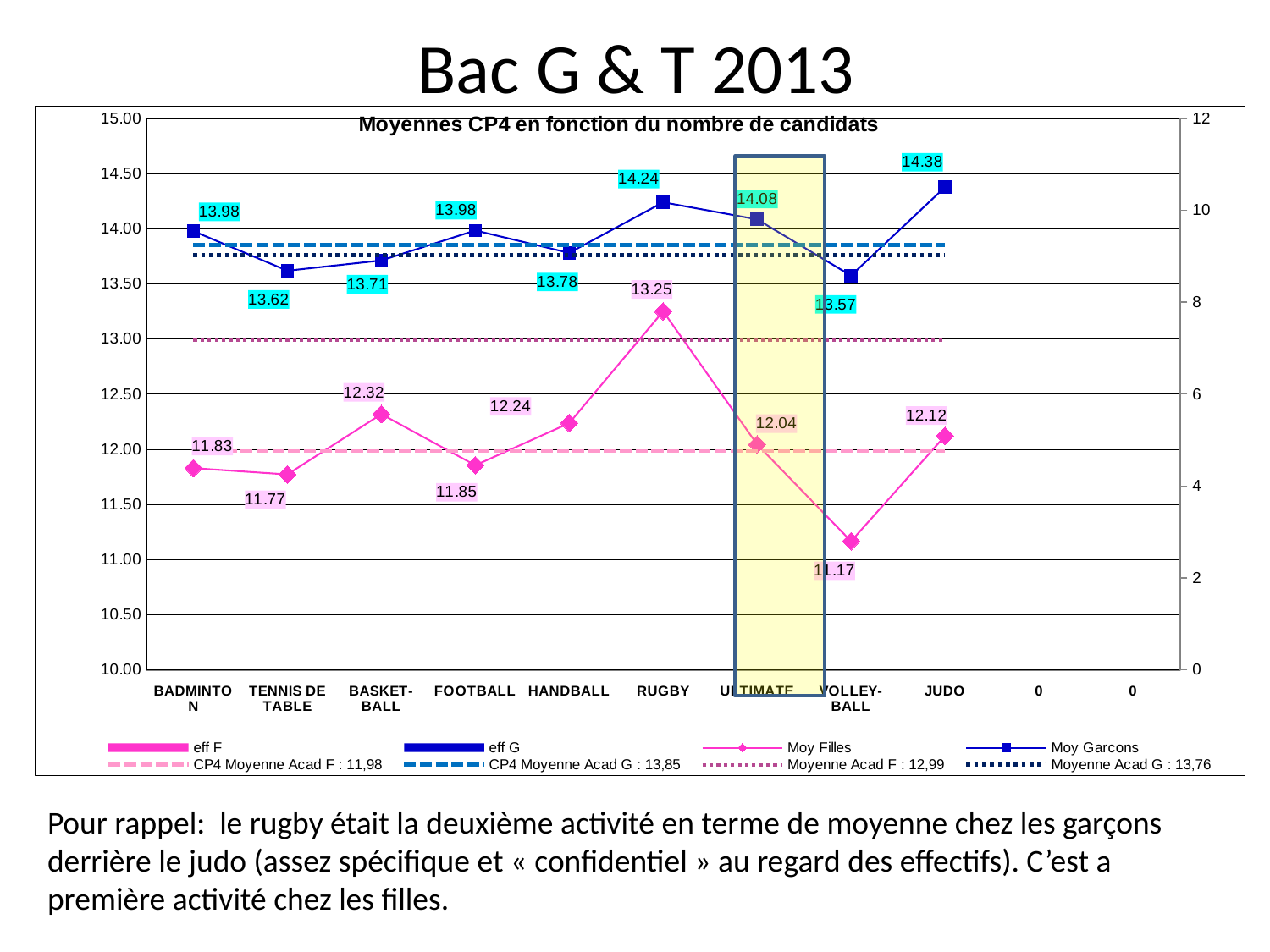
What is the Moy Garçons value for RUGBY? 14.24 Which activity has the highest Moy Garçons value? JUDO What value is given in the legend for CP4 Moyenne Acad G? 13,85 What is the difference between the Moy Garçons values for JUDO and RUGBY? 0.14 What is the Moy Filles value for VOLLEY-BALL? 11.17 Which activity has the highest Moy Filles value? RUGBY Which activity has the lowest Moy Filles value? VOLLEY-BALL What is the title of the chart? Moyennes CP4 en fonction du nombre de candidats Which is larger, the Moy Filles value for BASKET-BALL or for HANDBALL? BASKET-BALL What kind of chart is used to plot the Moy Filles and Moy Garçons series? Line chart How many entries does the legend list? 8 What is the difference between the Moy Filles values for RUGBY and VOLLEY-BALL? 2.08